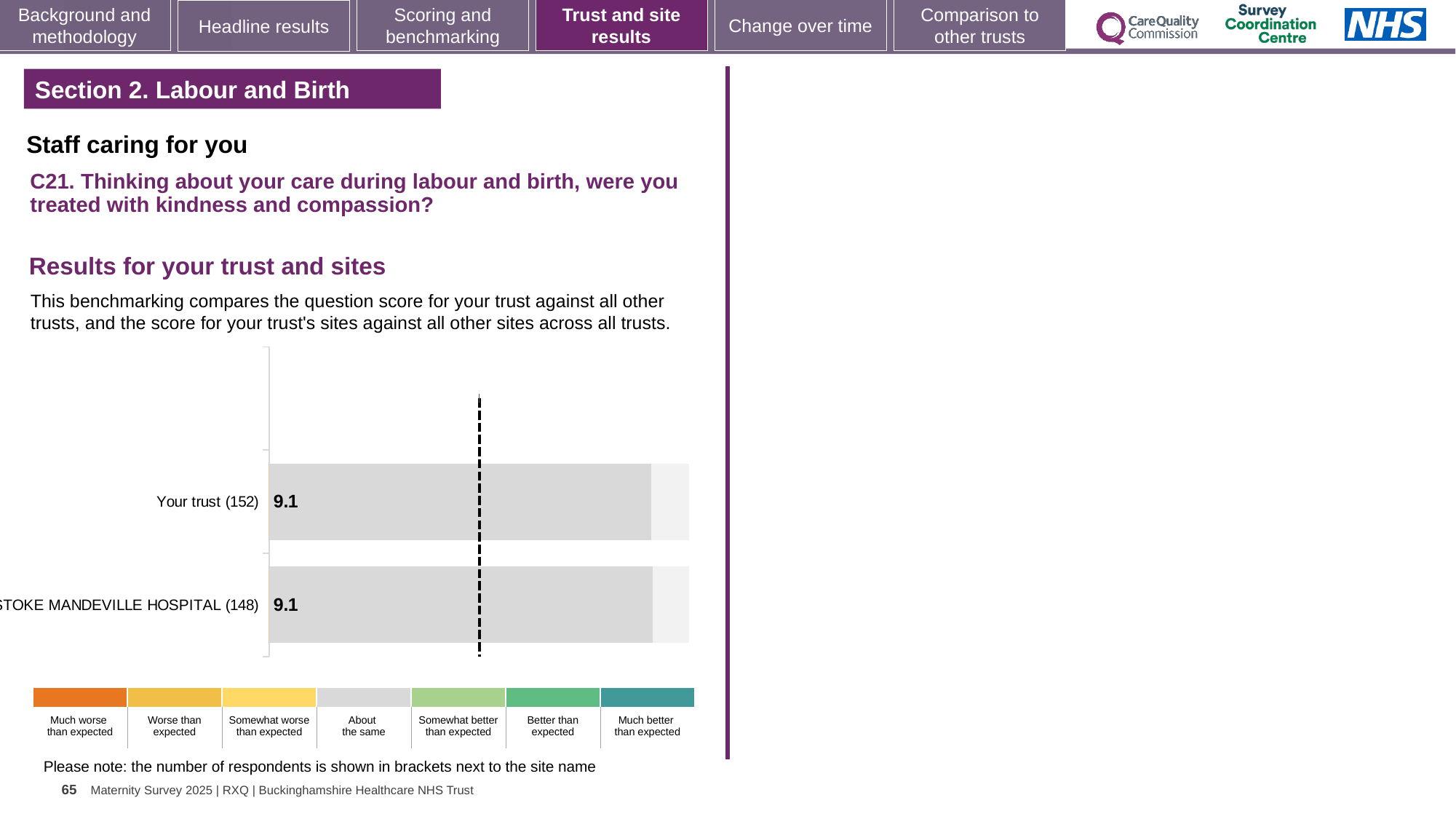
What is the score for Your trust on the chart? 9.1 What is the difference between the score for Your trust and the score for Stoke Mandeville Hospital? 0 Is the score for Your trust greater or less than 5? greater Which survey question does the chart relate to? C21. Thinking about your care during labour and birth, were you treated with kindness and compassion? What kind of chart is shown on the slide? Bar chart What is the score for Stoke Mandeville Hospital on the chart? 9.1 How many respondents are shown in brackets for Your trust? 152 How many respondents are shown in brackets for Stoke Mandeville Hospital? 148 How many bars are plotted on the chart? 2 How many categories does the colour key below the chart list? 7